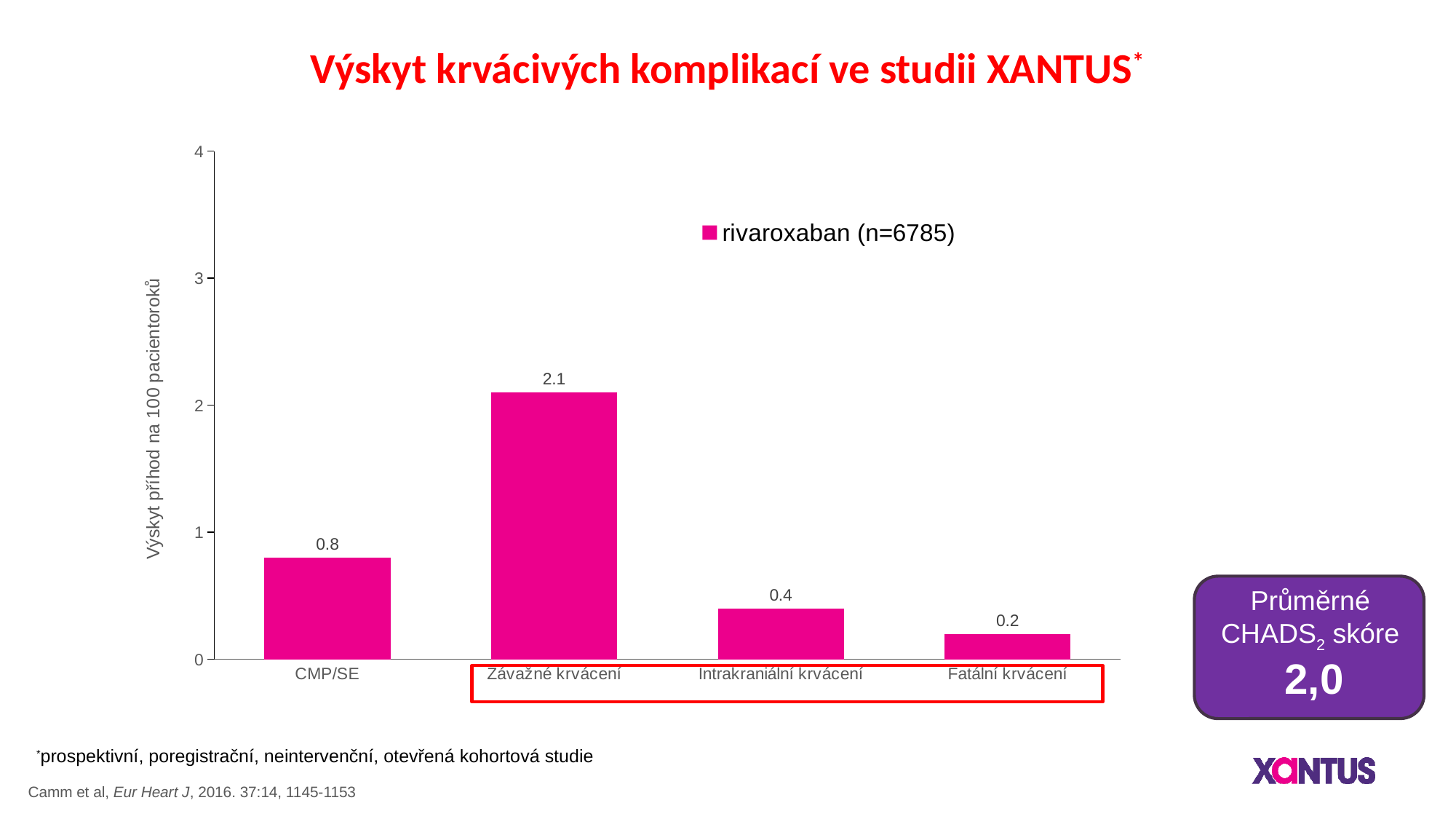
What is the value for Závažné krvácení? 2.1 What kind of chart is shown on the slide? bar chart What is the value for Intrakraniální krvácení? 0.4 Which is larger, the value for CMP/SE or the value for Intrakraniální krvácení? CMP/SE What is the value for CMP/SE? 0.8 How many categories are shown on the x axis? 4 What is the difference between the values for Závažné krvácení and CMP/SE? 1.3 What series does the legend list? rivaroxaban (n=6785) What is the value for Fatální krvácení? 0.2 Is the value for Závažné krvácení greater or less than 2? greater Which category has the lowest value? Fatální krvácení Which category has the highest value? Závažné krvácení